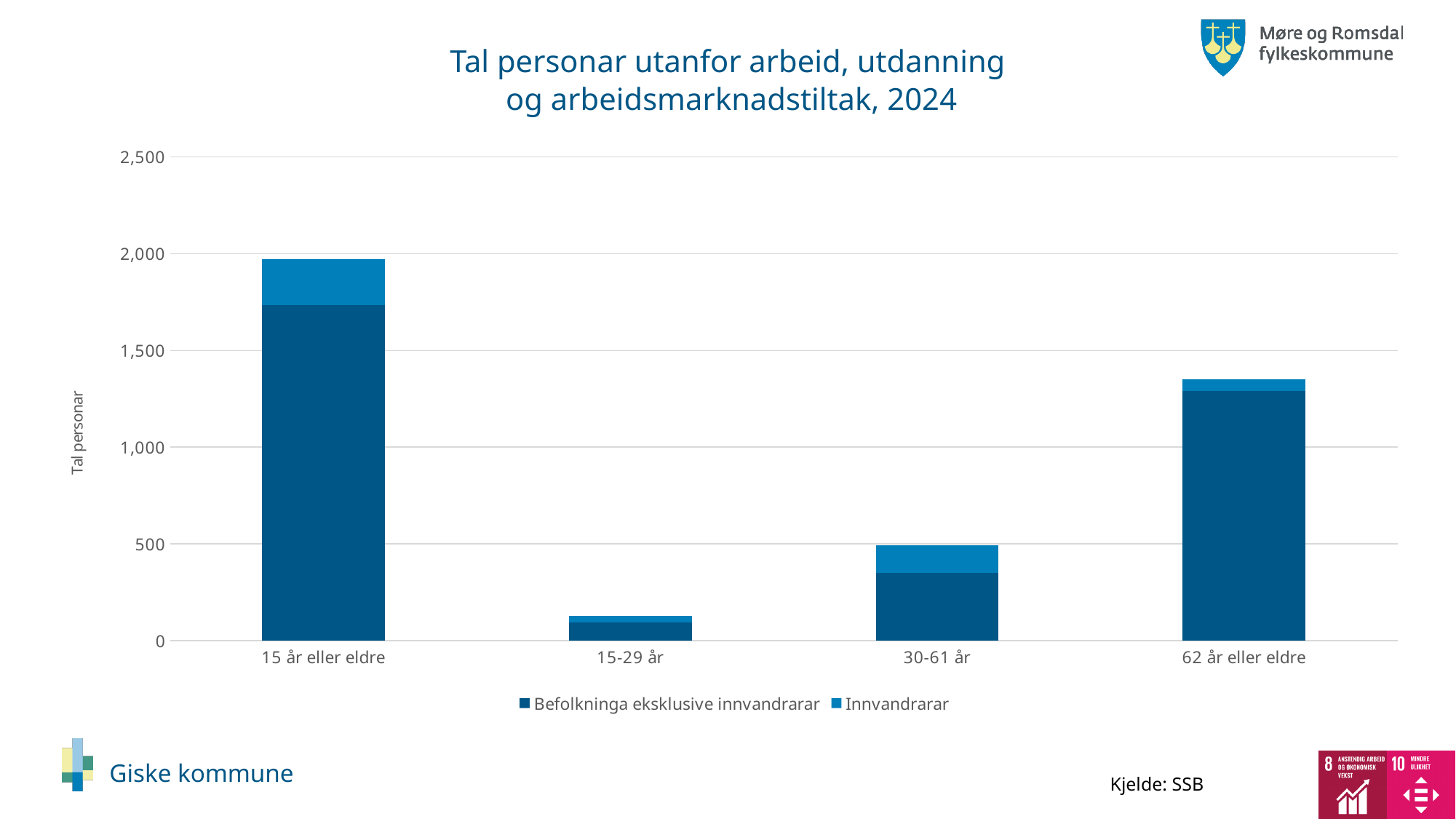
What kind of chart is shown on the slide? Stacked bar chart Which age category has the shortest bar? 15-29 år Which age category has the tallest bar? 15 år eller eldre What is the label on the vertical axis? Tal personar What is the second series listed in the legend? Innvandrarar How many series does the legend list? 2 Is the total bar for 30-61 år greater or less than 1,000? less Is the total bar for 62 år eller eldre greater or less than 1,000? greater Which bar is taller, 62 år eller eldre or 30-61 år? 62 år eller eldre Is the total bar for 15-29 år greater or less than 500? less How many age categories are shown on the x axis? 4